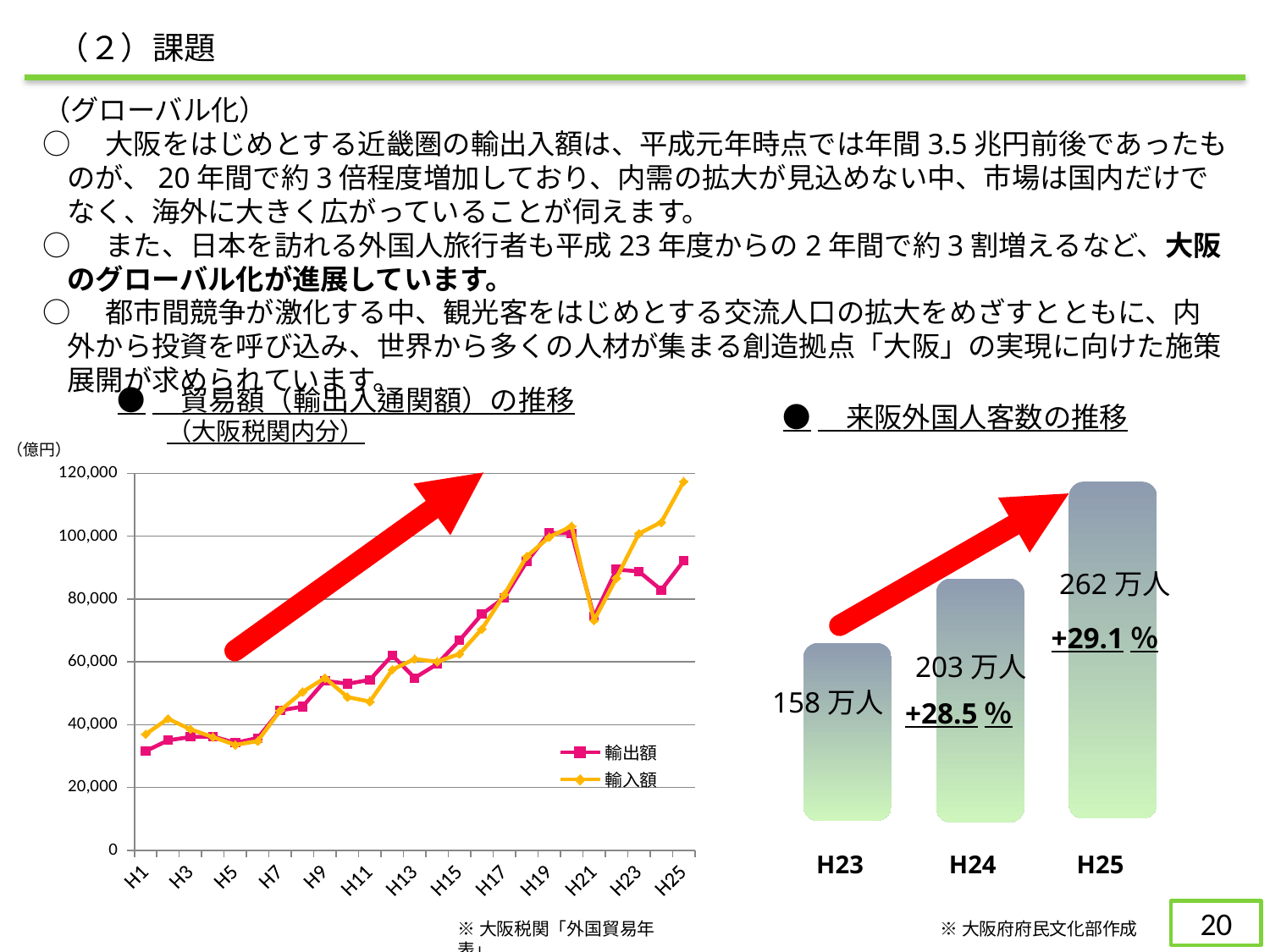
In the chart titled 来阪外国人客数の推移, how many years are shown? 3 What kind of chart is the chart titled 貿易額（輸出入通関額）の推移? line chart In the chart titled 来阪外国人客数の推移, what is the value for H23? 158 万人 In the chart titled 貿易額（輸出入通関額）の推移, which series has the larger value at H25, 輸出額 or 輸入額? 輸入額 In the chart titled 来阪外国人客数の推移, what is the value for H25? 262 万人 In the chart titled 来阪外国人客数の推移, do the values rise or fall from H23 to H25? rise In the chart titled 来阪外国人客数の推移, which year has the lowest value? H23 In the chart titled 来阪外国人客数の推移, what is the difference between the H25 and H23 values? 104 万人 In the chart titled 貿易額（輸出入通関額）の推移, is the value of 輸入額 at H25 greater or less than 100,000? greater In the chart titled 来阪外国人客数の推移, which year has the highest value? H25 In the chart titled 来阪外国人客数の推移, what growth rate is shown for H24? +28.5 % How many series does the legend of the chart titled 貿易額（輸出入通関額）の推移 list? 2